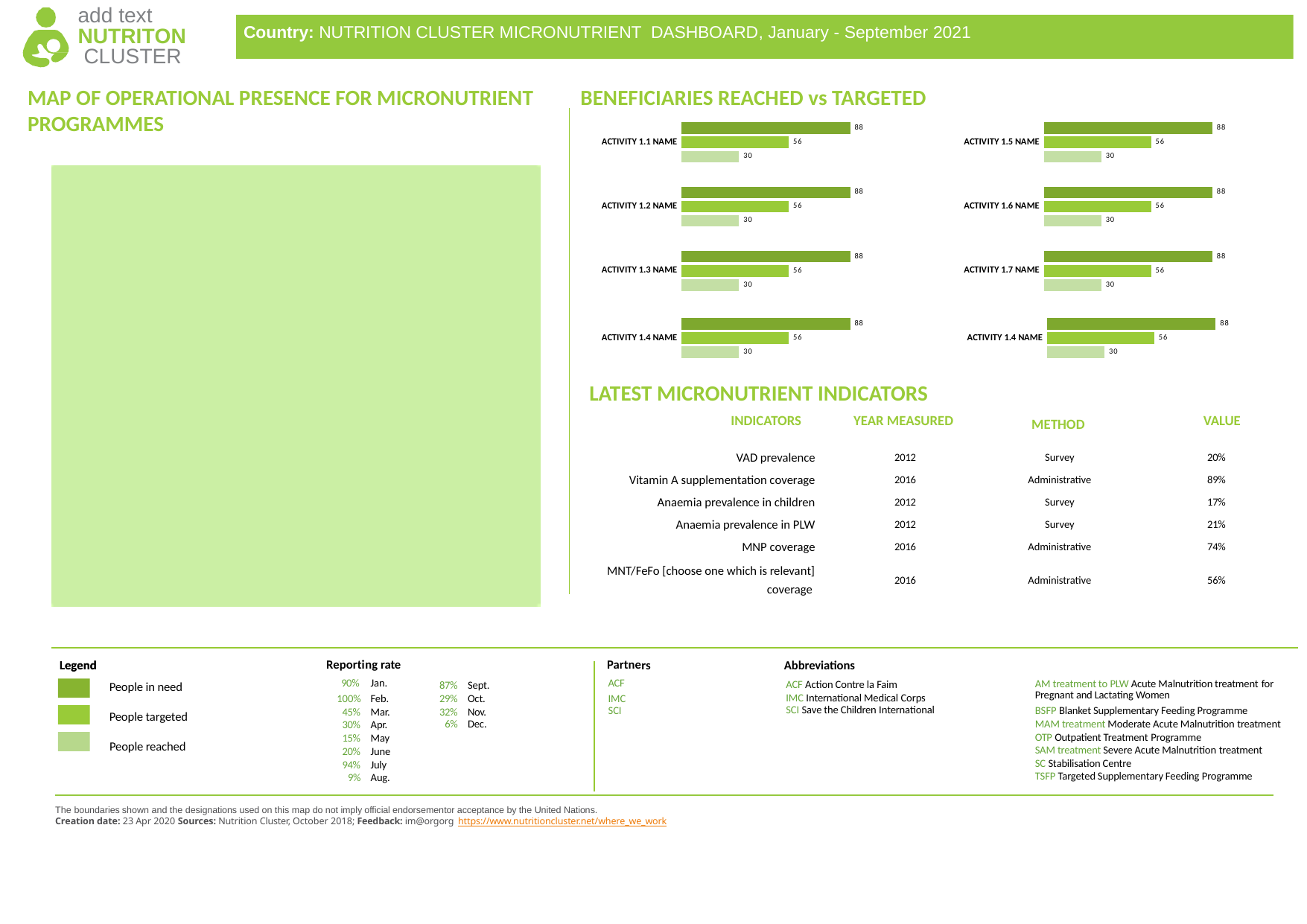
In the ACTIVITY 1.3 NAME chart, what is the difference between the top bar value and the bottom bar value? 58 In the ACTIVITY 1.5 NAME chart, which bar has the highest value? The top bar (88) In the ACTIVITY 1.6 NAME chart, what is the difference between the top bar value and the middle bar value? 32 In the ACTIVITY 1.2 NAME chart, what is the value of the middle bar? 56 In the ACTIVITY 1.7 NAME chart, which is larger, the middle bar or the bottom bar? The middle bar How many bars are shown in the ACTIVITY 1.1 NAME chart? 3 What type of chart is used for the BENEFICIARIES REACHED vs TARGETED section? Bar chart In the ACTIVITY 1.1 NAME chart under BENEFICIARIES REACHED vs TARGETED, what is the value of the top (longest) bar? 88 How many separate activity bar charts are shown under BENEFICIARIES REACHED vs TARGETED? 8 According to the legend at the bottom of the slide, what does the darkest green bar colour represent? People in need In the ACTIVITY 1.5 NAME chart, what is the value of the bottom (shortest) bar? 30 In the ACTIVITY 1.2 NAME chart, what is the total of the three bar values? 174